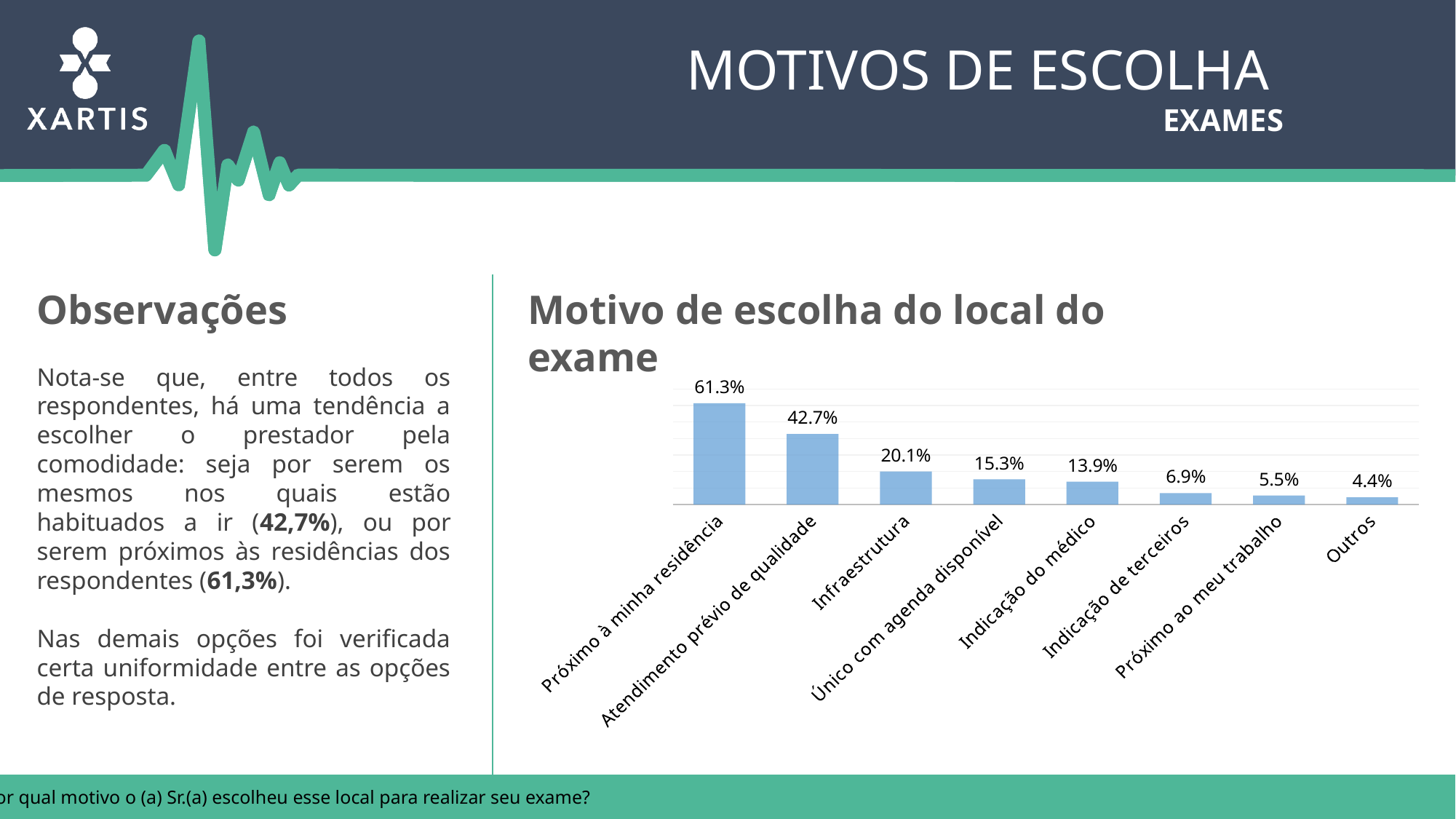
What is the value for "Infraestrutura"? 20.1% What is the value for "Indicação do médico"? 13.9% What kind of chart is shown? Bar chart Which category has the highest value? Próximo à minha residência What is the difference between "Próximo à minha residência" and "Atendimento prévio de qualidade"? 18.6% What is the value for "Próximo ao meu trabalho"? 5.5% Which is larger: "Único com agenda disponível" or "Indicação de terceiros"? Único com agenda disponível What is the value for "Próximo à minha residência"? 61.3% What is the title of the chart? Motivo de escolha do local do exame How many categories are shown in the chart? 8 Which category has the lowest value? Outros What is the value for "Atendimento prévio de qualidade"? 42.7%